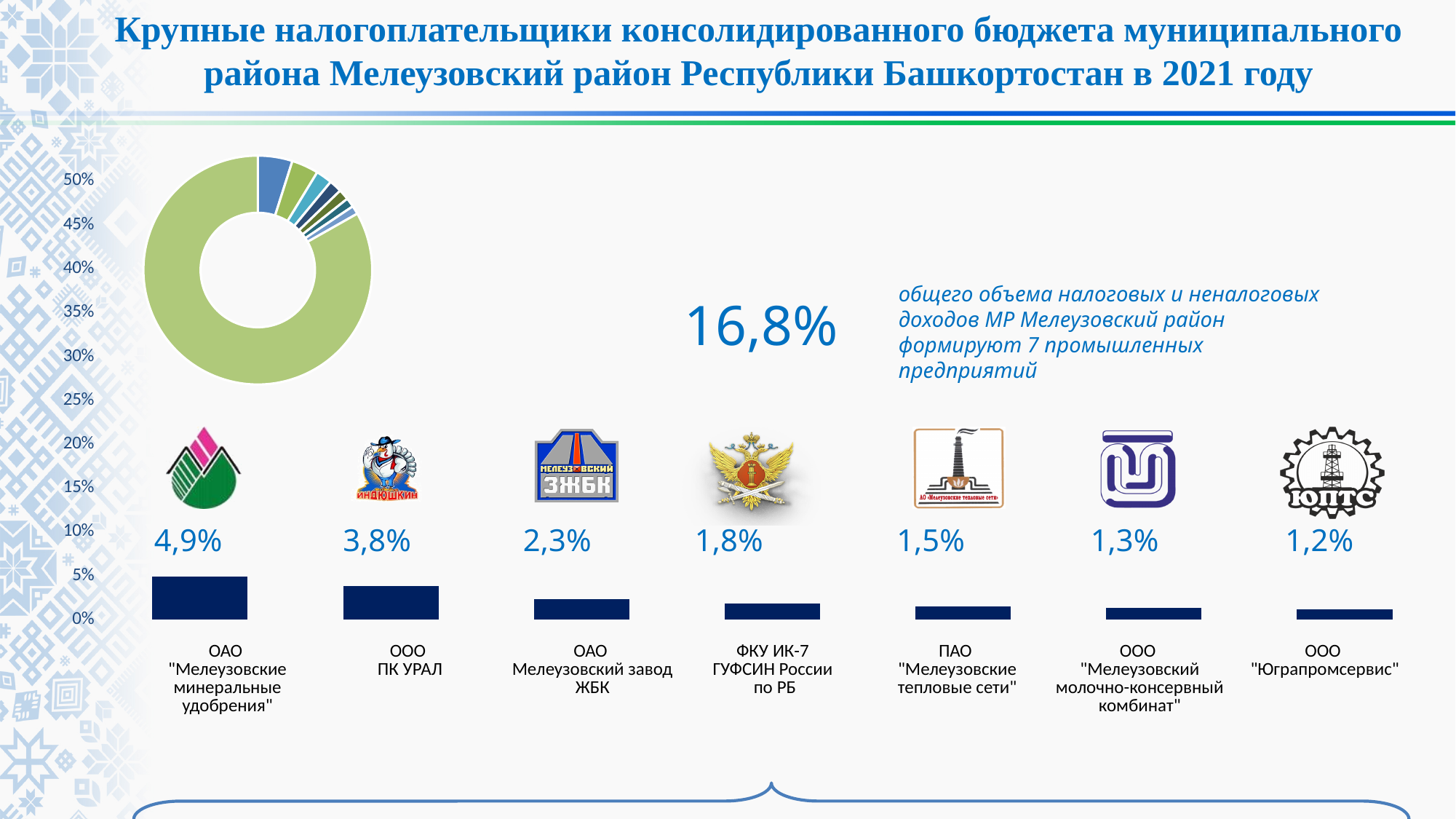
What kind of chart is the chart in the upper left of the slide? doughnut chart How many companies are shown in the bar chart? 7 In the bar chart, do the values rise or fall from left to right? fall What kind of chart is the chart at the bottom of the slide with company logos? bar chart In the bar chart, which company has the lowest value? ООО "Юграпромсервис" In the bar chart, which company has the highest value? ОАО "Мелеузовские минеральные удобрения" In the bar chart, what is the value for ФКУ ИК-7 ГУФСИН России по РБ? 1,8% In the bar chart, what is the value for ООО ПК УРАЛ? 3,8% What combined share of the district's tax and non-tax revenues do the 7 industrial enterprises form, according to the slide? 16,8% In the bar chart, which is larger: the value for ОАО Мелеузовский завод ЖБК or the value for ПАО "Мелеузовские тепловые сети"? ОАО Мелеузовский завод ЖБК In the bar chart, what is the difference between the values for ОАО "Мелеузовские минеральные удобрения" and ООО ПК УРАЛ? 1,1% In the bar chart, what is the value for ООО "Юграпромсервис"? 1,2%